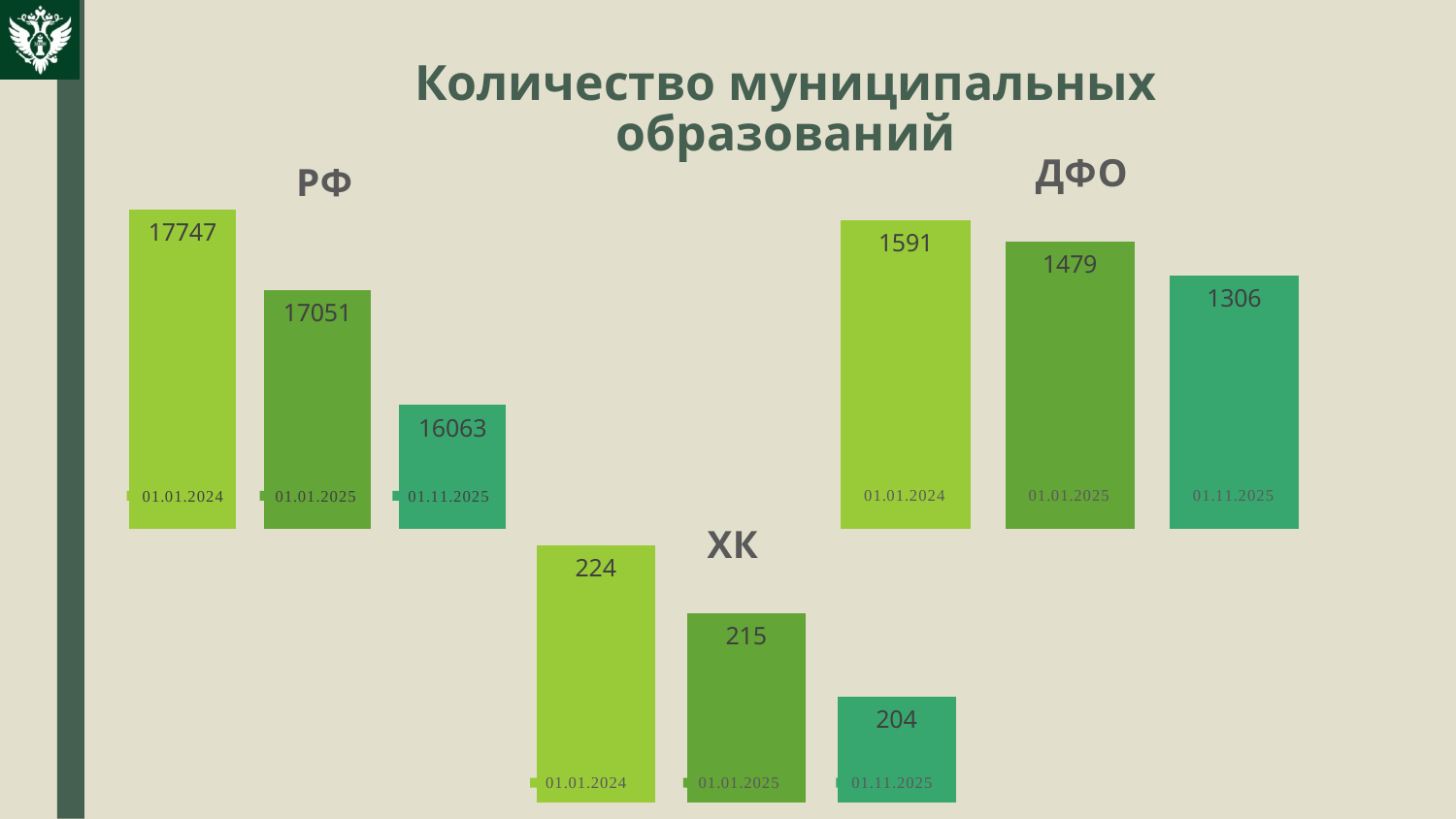
In the ДФО chart, which date has the highest value? 01.01.2024 In the ДФО chart, which is larger: the value for 01.01.2025 or the value for 01.11.2025? 01.01.2025 In the ДФО chart, what is the value for 01.11.2025? 1306 In the ХК chart, what is the value for 01.01.2025? 215 In the ХК chart, what is the difference between the values for 01.01.2024 and 01.11.2025? 20 In the РФ chart, which date has the lowest value? 01.11.2025 In the РФ chart, what is the difference between the values for 01.01.2024 and 01.01.2025? 696 How many charts are shown on the slide? 3 In the РФ chart, what is the value for 01.01.2024? 17747 What kind of chart is the РФ chart? bar chart How many bars are in the ХК chart? 3 In the ДФО chart, do the values rise or fall from 01.01.2024 to 01.11.2025? fall